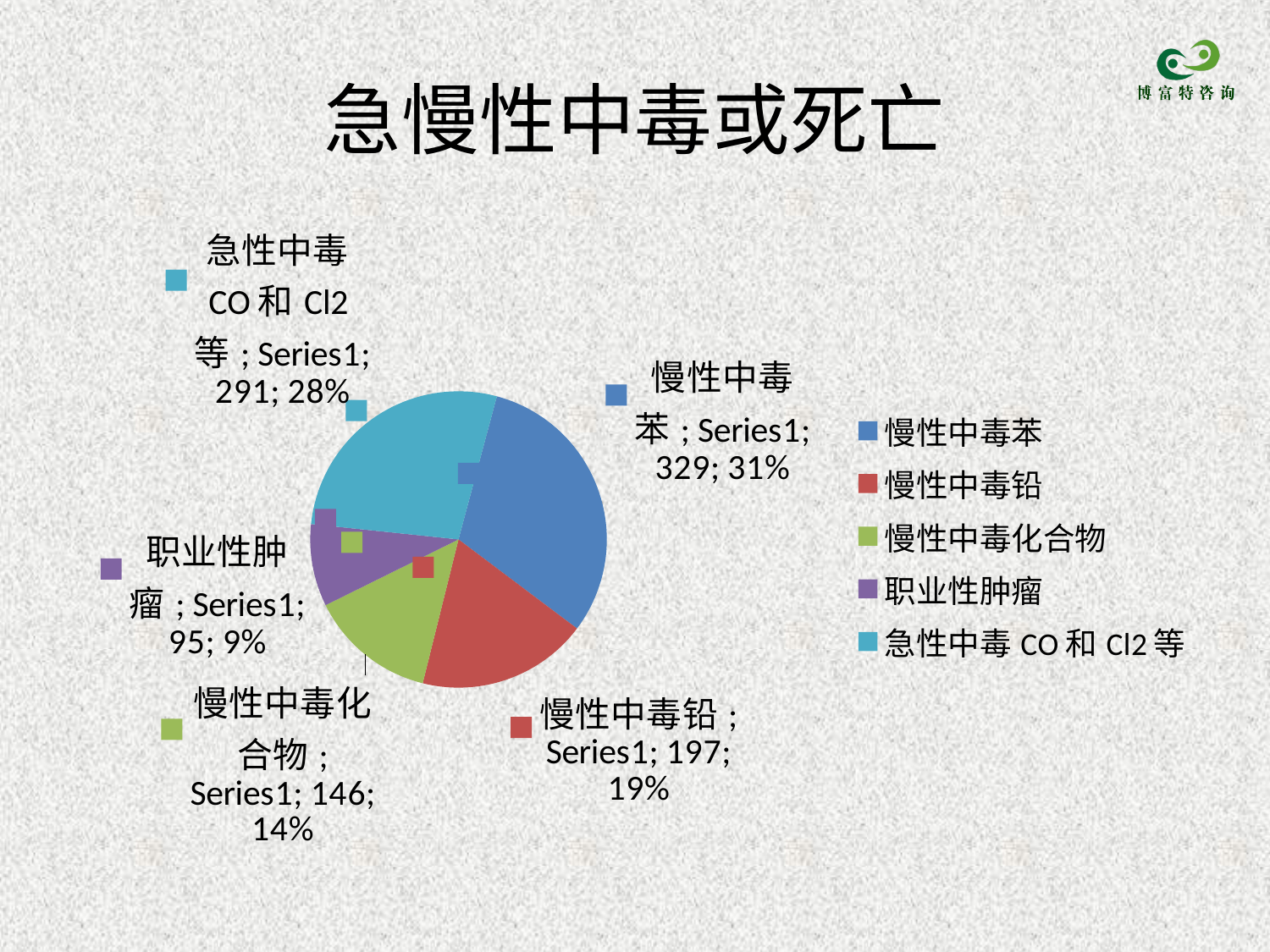
What share of the pie does 慢性中毒苯 represent? 31% Which category has the smallest slice? 职业性肿瘤 What is the difference between the values for 慢性中毒苯 and 急性中毒 CO 和 Cl2 等? 38 What is the value for 慢性中毒苯? 329 What share of the pie does 慢性中毒化合物 represent? 14% What is the value for 慢性中毒铅? 197 What kind of chart is shown on the slide? pie chart How many categories does the pie chart have? 5 Which is larger, the value for 慢性中毒铅 or the value for 慢性中毒化合物? 慢性中毒铅 Which category has the largest slice? 慢性中毒苯 What is the value for 急性中毒 CO 和 Cl2 等? 291 What is the value for 职业性肿瘤? 95